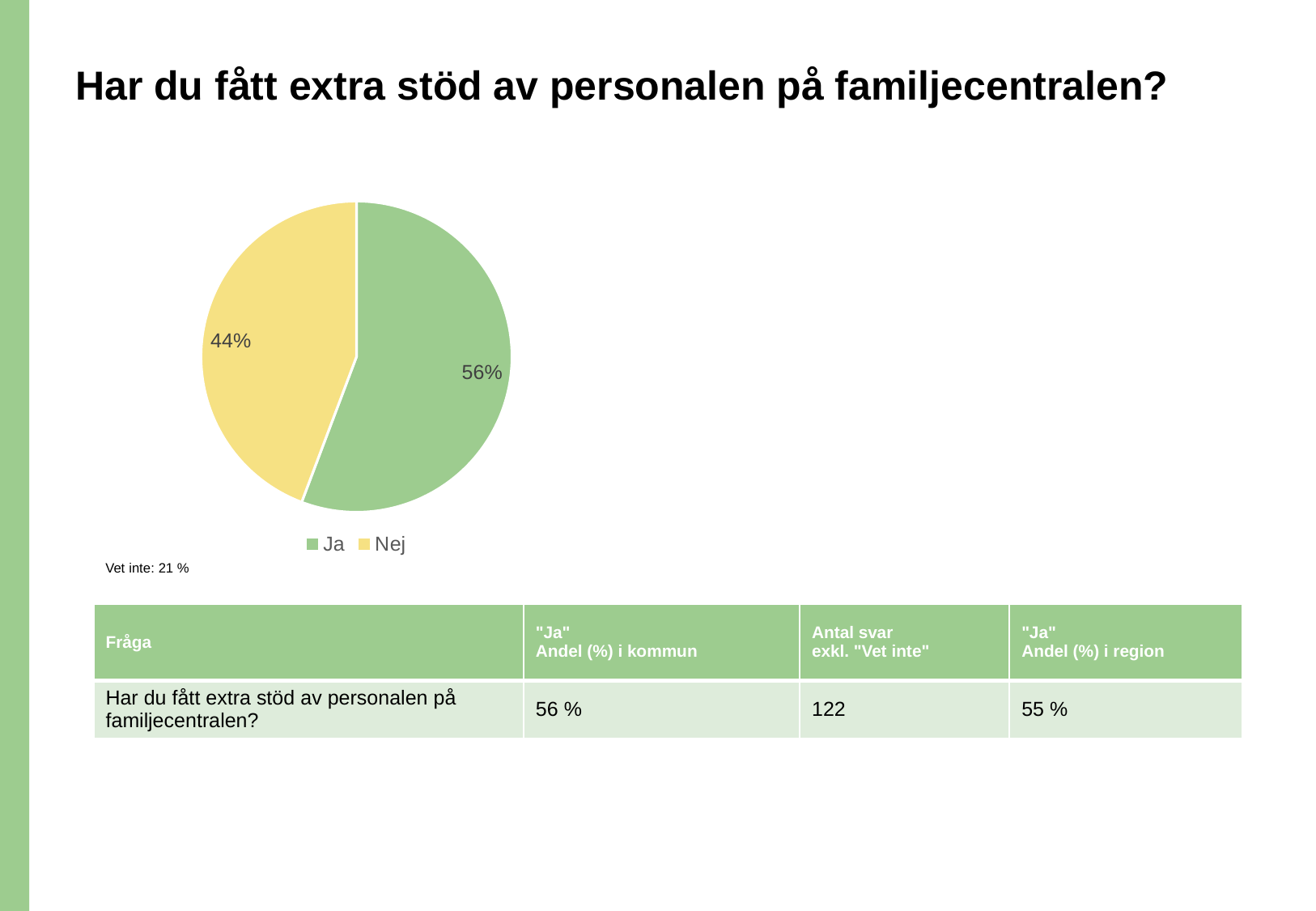
What kind of chart is shown on the slide? pie chart What is the difference in percentage points between the "Ja" and "Nej" slices? 12 Is the share for "Ja" greater or less than 50%? greater Which slice of the pie is the largest? Ja What share of the pie does "Ja" represent? 56% What colour is the "Ja" slice in the pie chart? green What share of the pie does "Nej" represent? 44% Which is larger, the "Ja" slice or the "Nej" slice? Ja Which slice of the pie is the smallest? Nej How many slices does the pie chart have? 2 What colour is the "Nej" slice in the pie chart? yellow How many entries does the legend list? 2